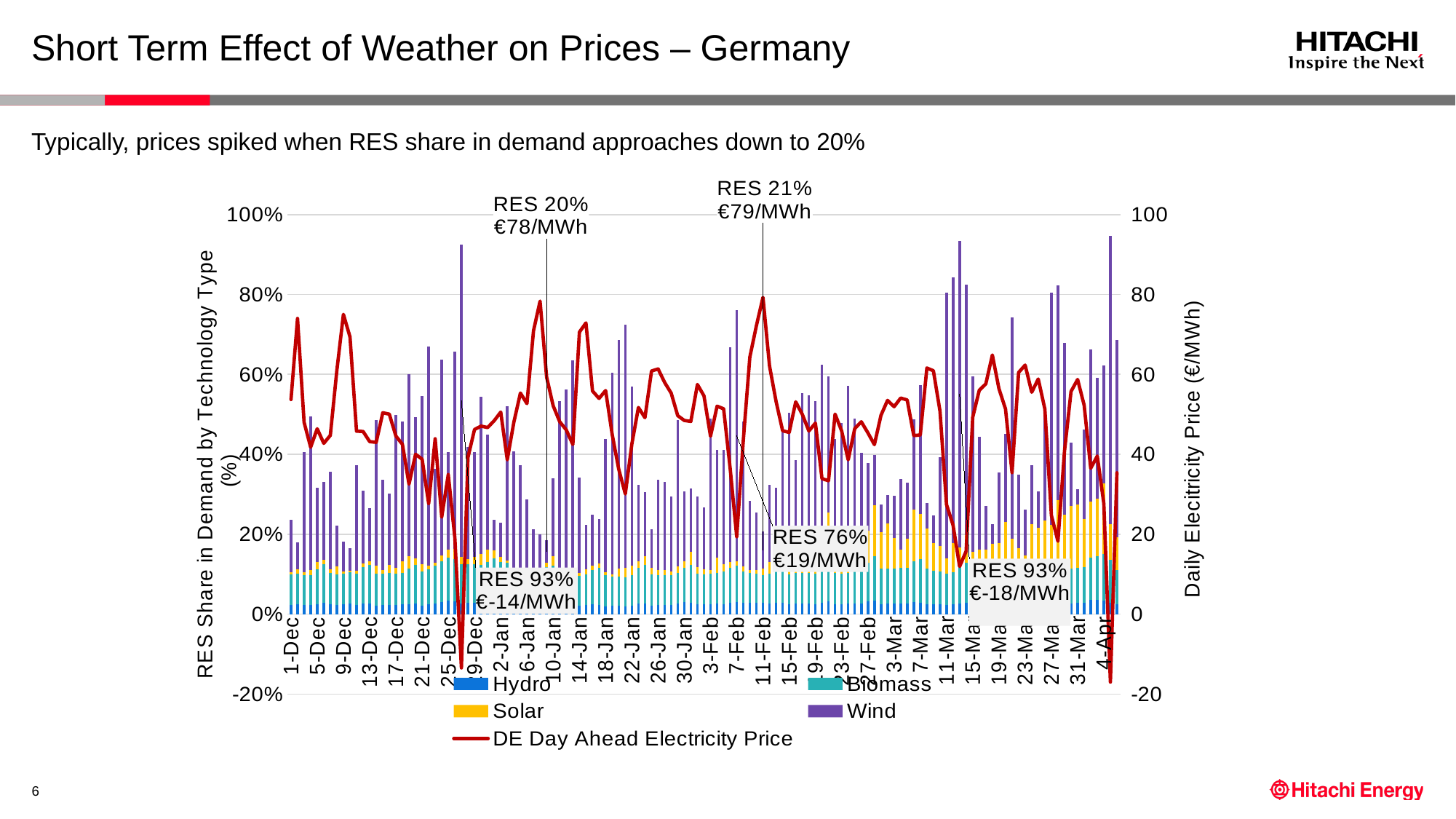
What is the highest electricity price among the annotated points? €79/MWh How many series does the legend list? 5 Which annotated price is higher: the one at RES 20% or the one at RES 21%? RES 21% (€79/MWh) What RES share is annotated alongside the price of €19/MWh? 76% What electricity price is annotated at the point where the RES share is 21%? €79/MWh How many annotated data points with RES share and price are shown on the chart? 5 Which legend entry is drawn as a red line? DE Day Ahead Electricity Price What is the lowest electricity price among the annotated points? €-18/MWh What electricity price is annotated at the point where the RES share is 20%? €78/MWh What kind of chart is shown on the slide? Combined stacked bar and line chart What is the title of the right-hand vertical axis? Daily Electricity Price (€/MWh) What is the difference between the annotated prices at RES 21% and RES 20%? €1/MWh